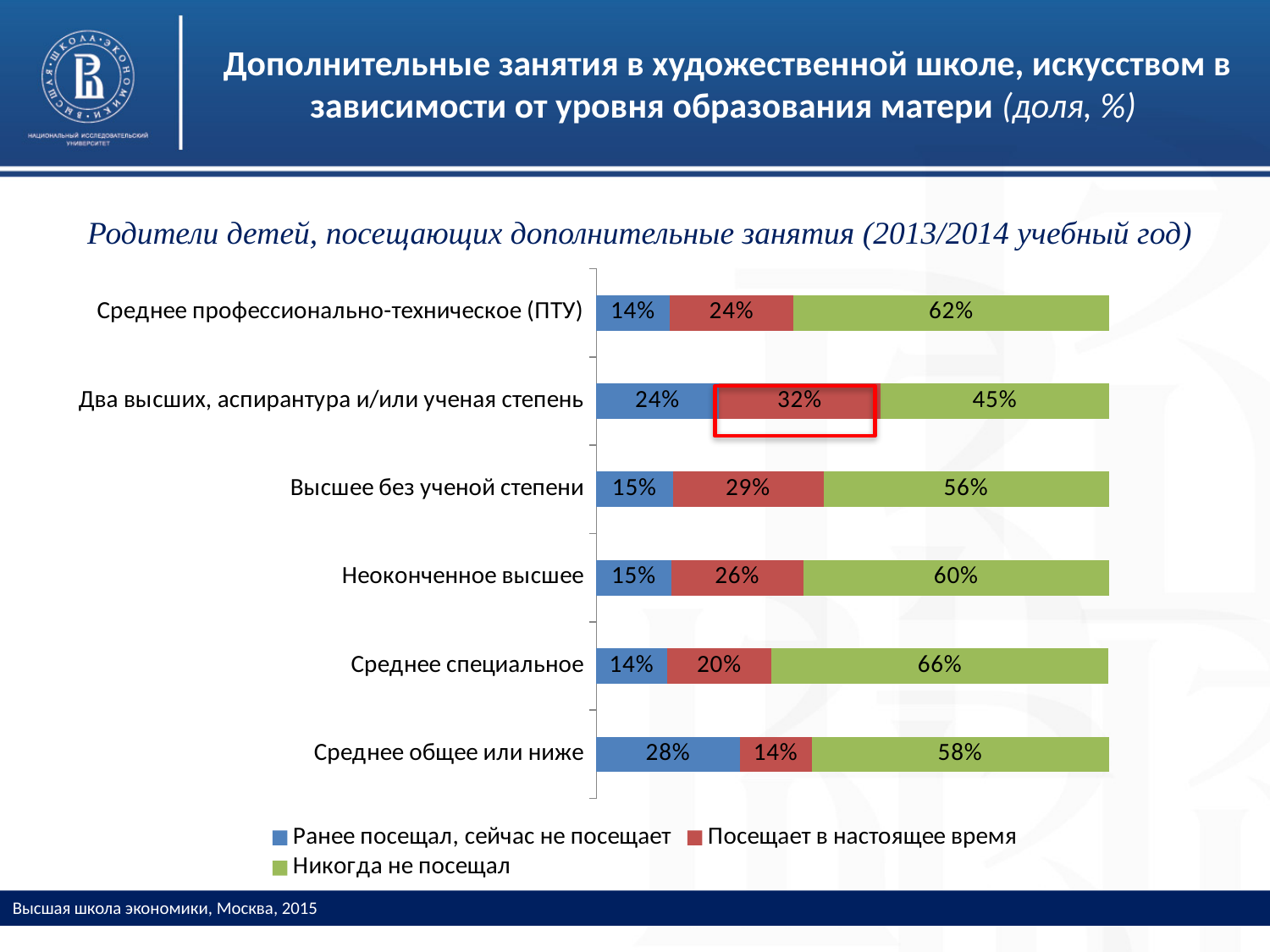
Which value on the chart is highlighted with a red box? 32% Which category has the lowest value for "Посещает в настоящее время"? Среднее общее или ниже How many series does the legend list? 3 Which is larger: the "Посещает в настоящее время" value for "Высшее без ученой степени" or for "Неоконченное высшее"? Высшее без ученой степени Which series is shown in green on the chart? Никогда не посещал How many categories of mother's education are shown on the chart? 6 What type of chart is shown on the slide? Stacked bar chart What is the value of "Никогда не посещал" for "Среднее специальное"? 66% What is the value of "Ранее посещал, сейчас не посещает" for "Среднее общее или ниже"? 28% What is the difference between the "Никогда не посещал" values for "Среднее профессионально-техническое (ПТУ)" and "Два высших, аспирантура и/или ученая степень"? 17% What is the value of "Посещает в настоящее время" for "Два высших, аспирантура и/или ученая степень"? 32% Which category has the highest value for "Никогда не посещал"? Среднее специальное